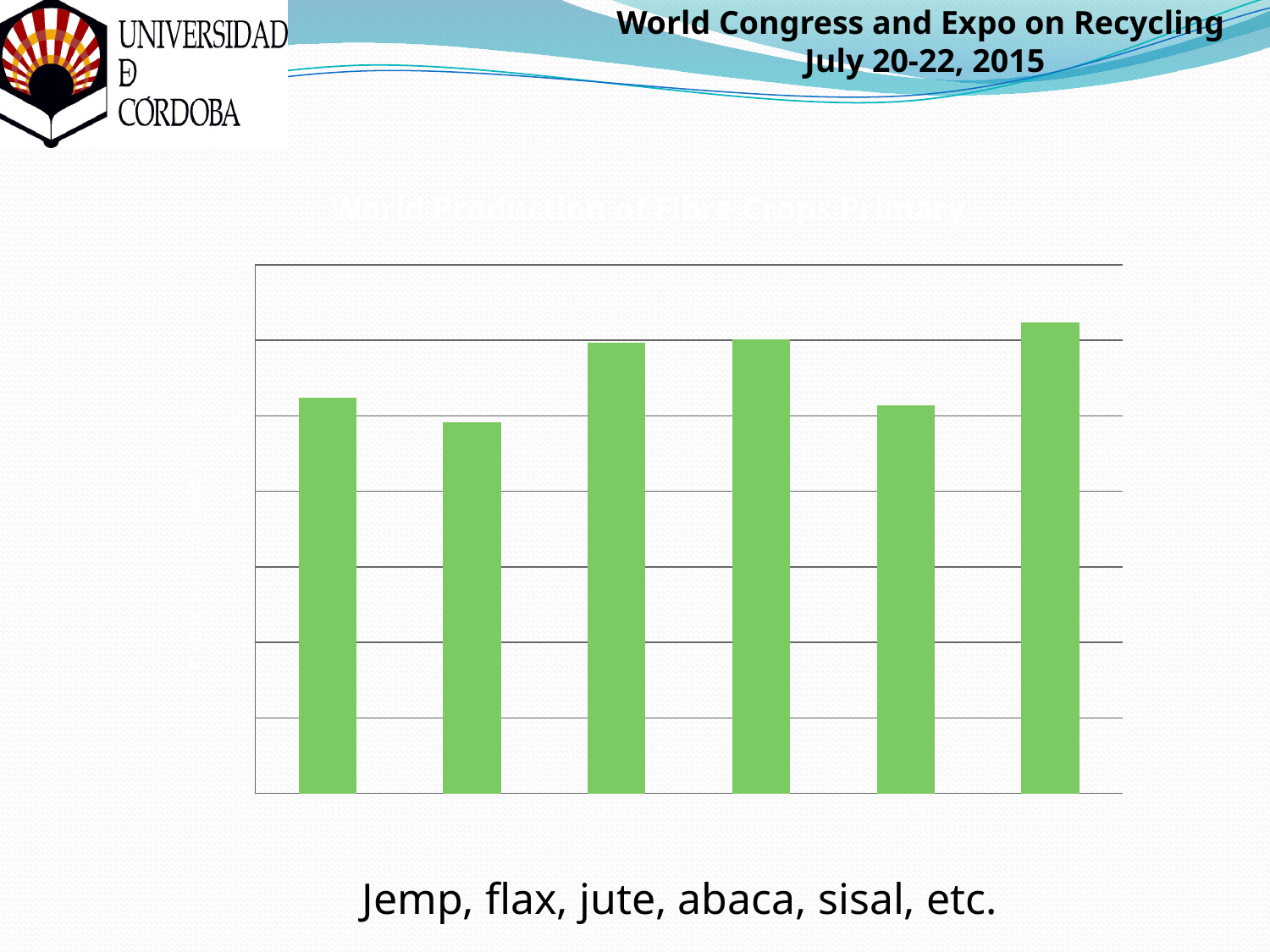
What is the title of the chart? World Production of Fibre Crops Primary What kind of chart is shown on the slide? bar chart Which is taller, the third bar or the fifth bar from the left? the third bar How many bars are plotted in the chart? 6 Which is taller, the sixth bar or the fourth bar from the left? the sixth bar Which bar is the shortest in the chart, counting from the left? the second bar What colour are the bars in the chart? green Which is taller, the first bar or the second bar from the left? the first bar Which bar is the tallest in the chart, counting from the left? the sixth (rightmost) bar